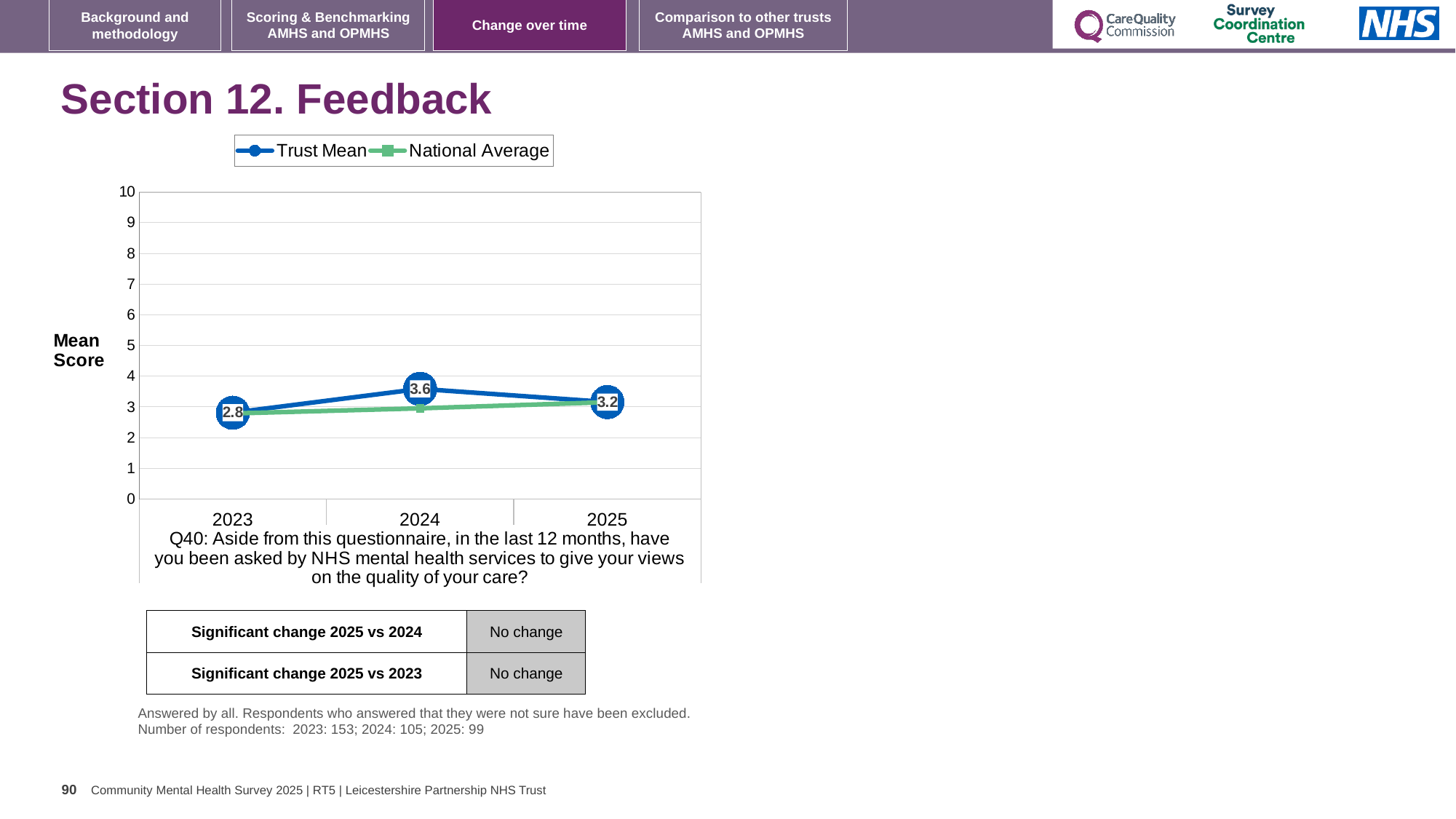
In which year is the Trust Mean score highest? 2024 How many series does the legend list? 2 What is the Trust Mean score for 2024? 3.6 In which year is the Trust Mean score lowest? 2023 Which is larger, the Trust Mean score for 2025 or for 2023? 2025 What kind of chart is shown on the slide? Line chart Is the National Average value for 2024 greater or less than 5? less What is the Trust Mean score for 2023? 2.8 What is the difference between the Trust Mean scores for 2024 and 2025? 0.4 What is the difference between the Trust Mean scores for 2024 and 2023? 0.8 How many years are shown on the x axis? 3 What is the Trust Mean score for 2025? 3.2